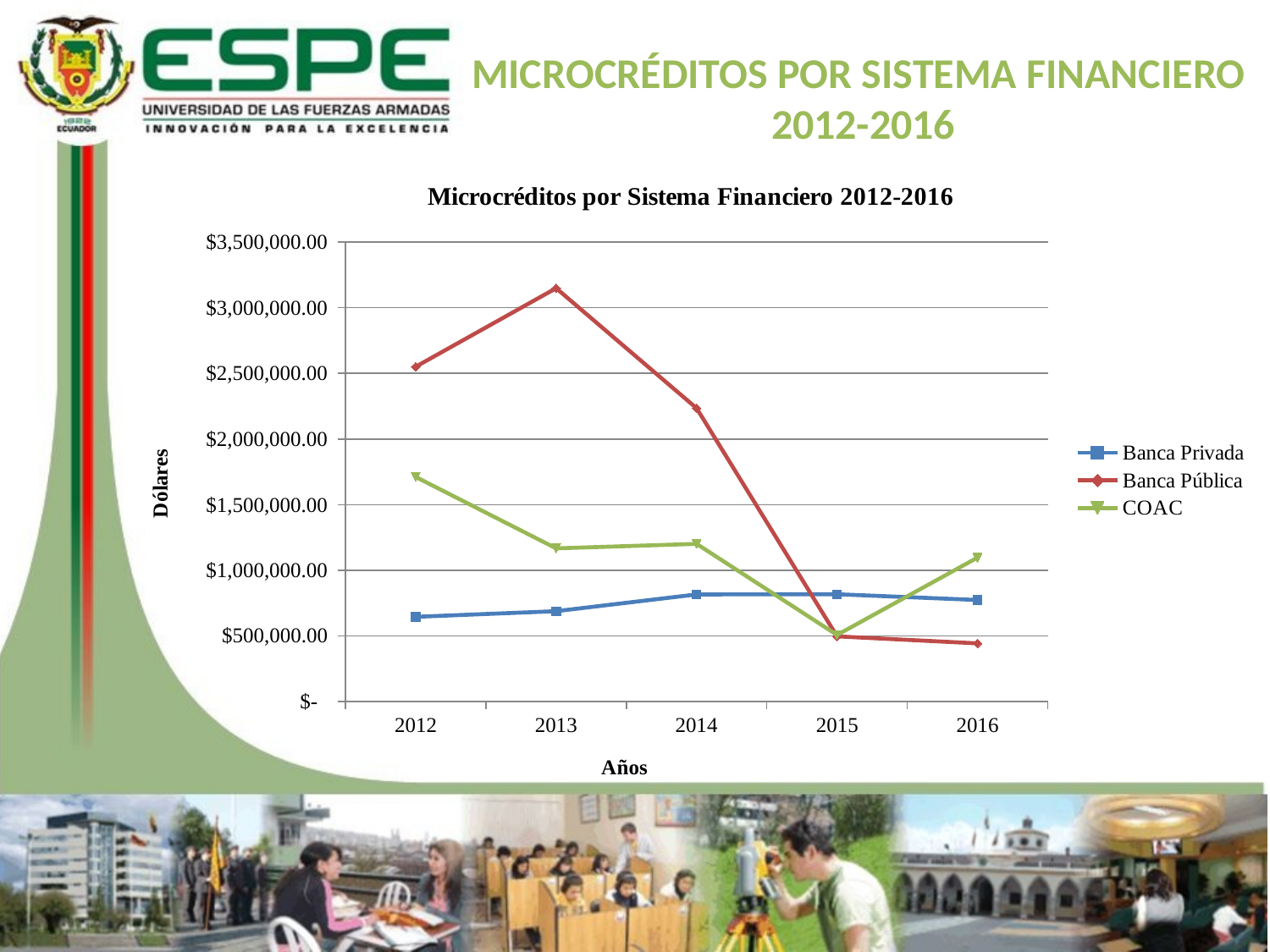
In which year does Banca Pública reach its highest value? 2013 In which year does Banca Pública reach its lowest value? 2016 How many series does the legend list? 3 Which series has the larger value in 2015, Banca Privada or Banca Pública? Banca Privada What is the label of the vertical axis? Dólares Is the value for Banca Pública in 2016 greater or less than $500,000.00? less In which year does COAC reach its highest value? 2012 How many years are plotted along the x axis? 5 Does the value for Banca Pública rise or fall from 2013 to 2016? Fall Is the value for COAC in 2016 greater or less than $1,000,000.00? greater What kind of chart is shown on the slide? Line chart Is the value for Banca Pública in 2013 greater or less than $3,000,000.00? greater